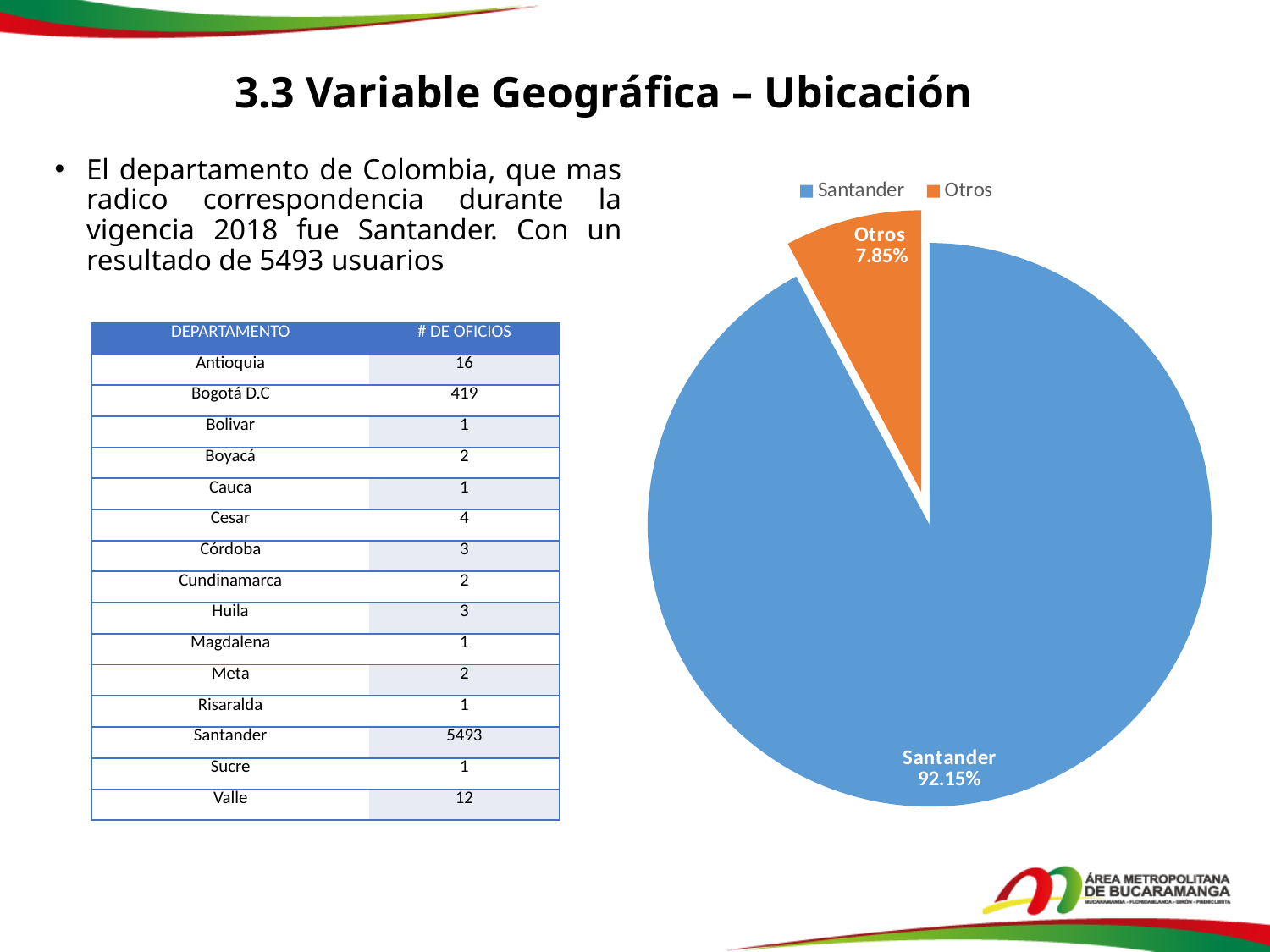
What colour is the Otros slice in the pie chart? orange What colour is the Santander slice in the pie chart? blue What is the difference in percentage points between the Santander and Otros slices? 84.30 What kind of chart is shown on the slide? pie chart How many slices does the pie chart have? 2 What share of the pie does Otros represent? 7.85% Which slice of the pie chart is the smallest? Otros Which slice of the pie chart is the largest? Santander How many entries does the legend of the pie chart list? 2 What share of the pie does Santander represent? 92.15% Which is larger in the pie chart, Santander or Otros? Santander